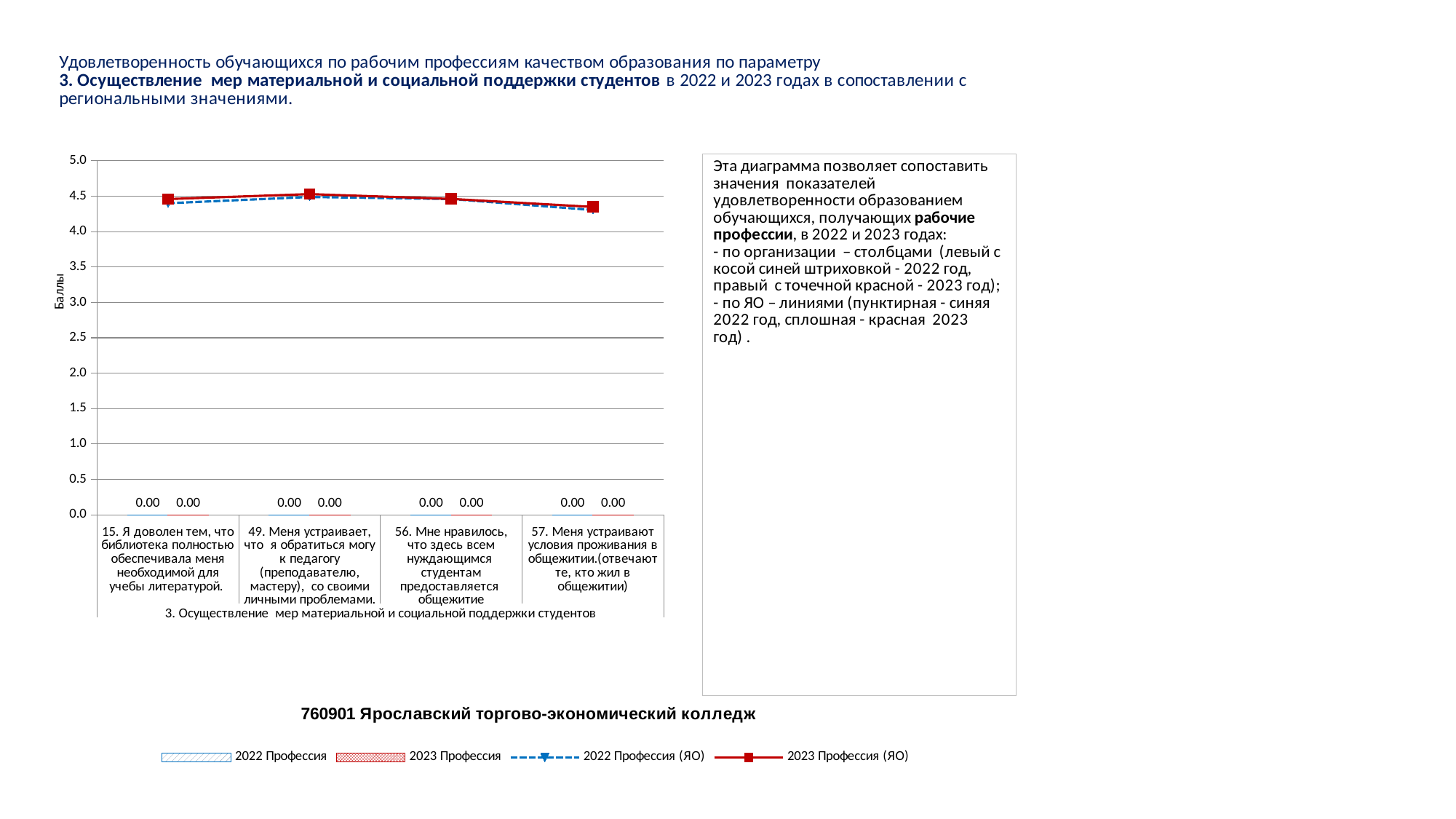
Does the 2023 Профессия (ЯО) line rise or fall from category 49 to category 57? fall Is the value of the 2022 Профессия (ЯО) line at category "57. Меня устраивают условия проживания в общежитии.(отвечают те, кто жил в общежитии)" greater or less than 4.5? less What kind of chart is shown on the slide? A combined bar and line chart Is the value of the 2023 Профессия (ЯО) line at category "49. Меня устраивает, что я обратиться могу к педагогу (преподавателю, мастеру), со своими личными проблемами." greater or less than 4.0? greater What is the data label shown for the 2023 Профессия series at category "57. Меня устраивают условия проживания в общежитии.(отвечают те, кто жил в общежитии)"? 0.00 How many categories are shown on the x axis of the chart? 4 What is the title shown below the chart? 760901 Ярославский торгово-экономический колледж At which category is the 2023 Профессия (ЯО) line lowest? 57. Меня устраивают условия проживания в общежитии.(отвечают те, кто жил в общежитии) What is the data label shown for the 2022 Профессия series at category "15. Я доволен тем, что библиотека полностью обеспечивала меня необходимой для учебы литературой."? 0.00 What is the label of the vertical axis of the chart? Баллы What is the difference between the 2022 Профессия and 2023 Профессия values at category "56. Мне нравилось, что здесь всем нуждающимся студентам предоставляется общежитие"? 0.00 How many series does the chart legend list? 4